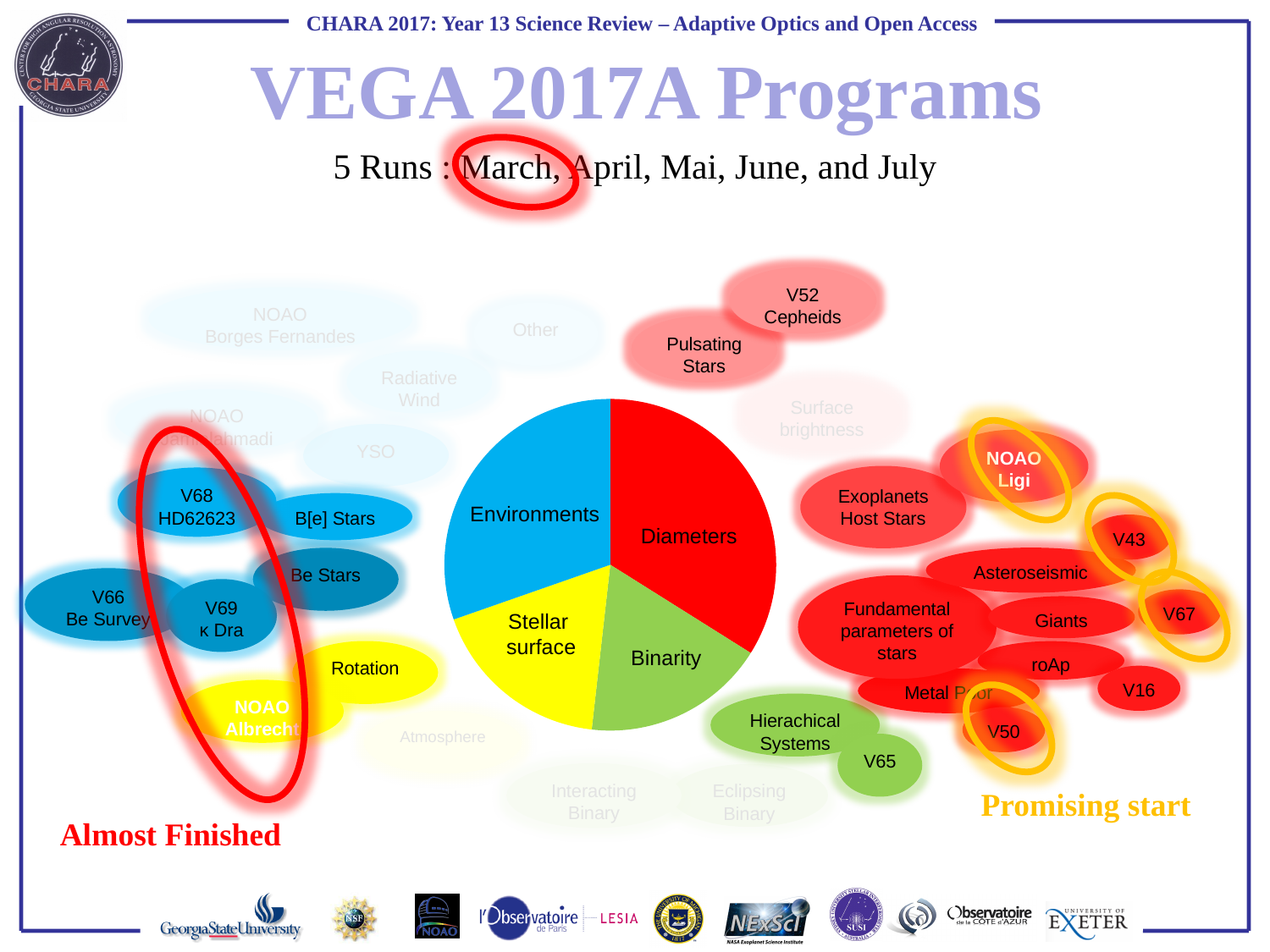
Which slice of the pie chart is the largest? Diameters What kind of chart is shown in the centre of the slide? pie chart How many slices does the pie chart have? 4 Which slice of the pie chart is coloured yellow? Stellar surface In the pie chart, which slice is larger, Environments or Binarity? Environments In the pie chart, which slice is larger, Diameters or Environments? Diameters What colour is the Diameters slice of the pie chart? red In the pie chart, which slice is larger, Diameters or Binarity? Diameters